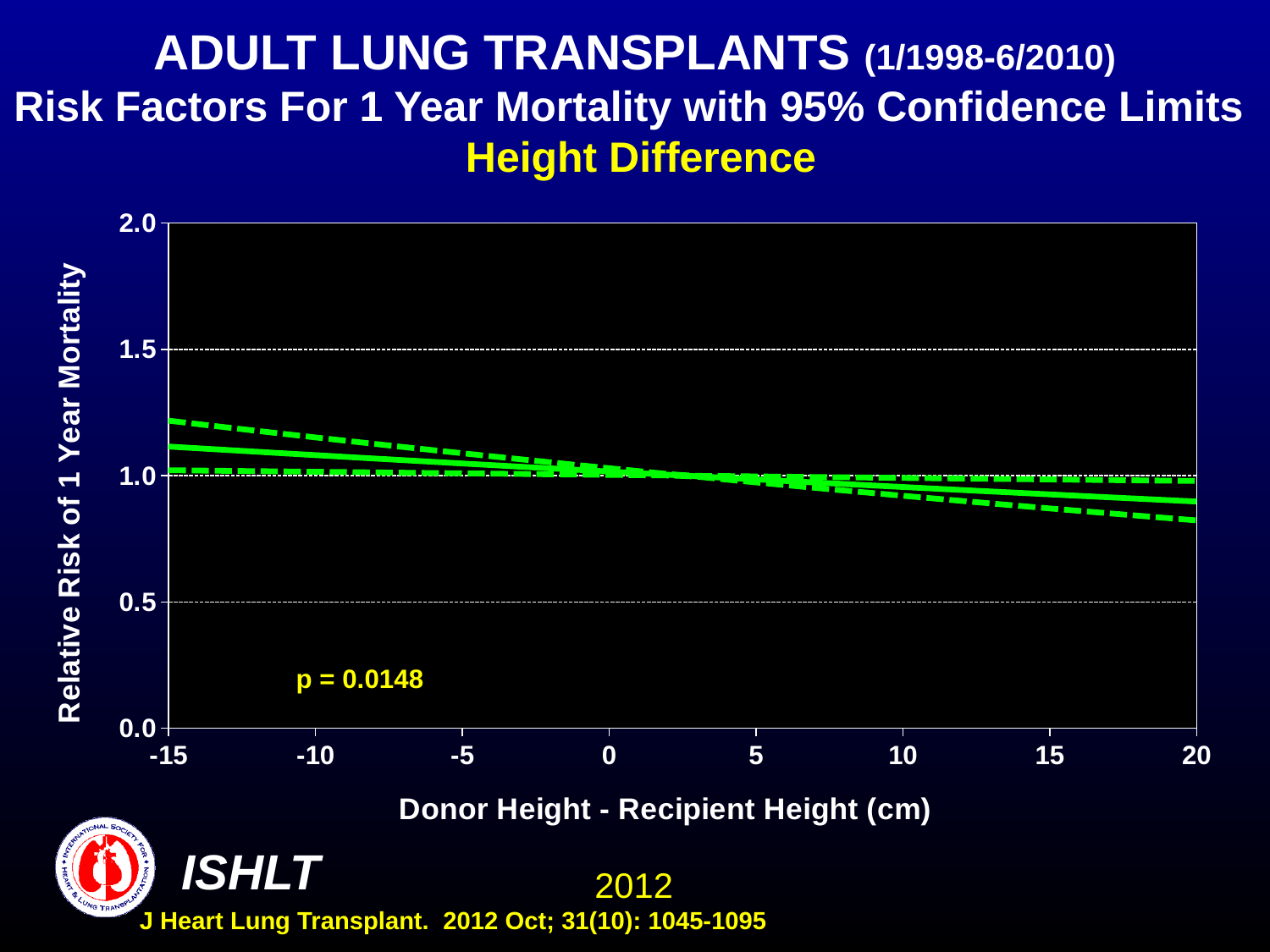
What kind of chart is shown on the slide? line chart What is the label of the x axis? Donor Height - Recipient Height (cm) Is the upper 95% confidence limit at a height difference of -15 cm greater or less than 1.5? less What is the highest value shown on the y axis? 2.0 Is the lower 95% confidence limit at a height difference of 20 cm greater or less than 0.5? greater What is the lowest value shown on the x axis? -15 Does the solid relative risk line rise or fall as Donor Height - Recipient Height increases from -15 to 20 cm? fall Is the relative risk on the solid line at a height difference of -15 cm greater or less than 1.0? greater How many lines are plotted on the chart? 3 What p-value is printed on the chart? p = 0.0148